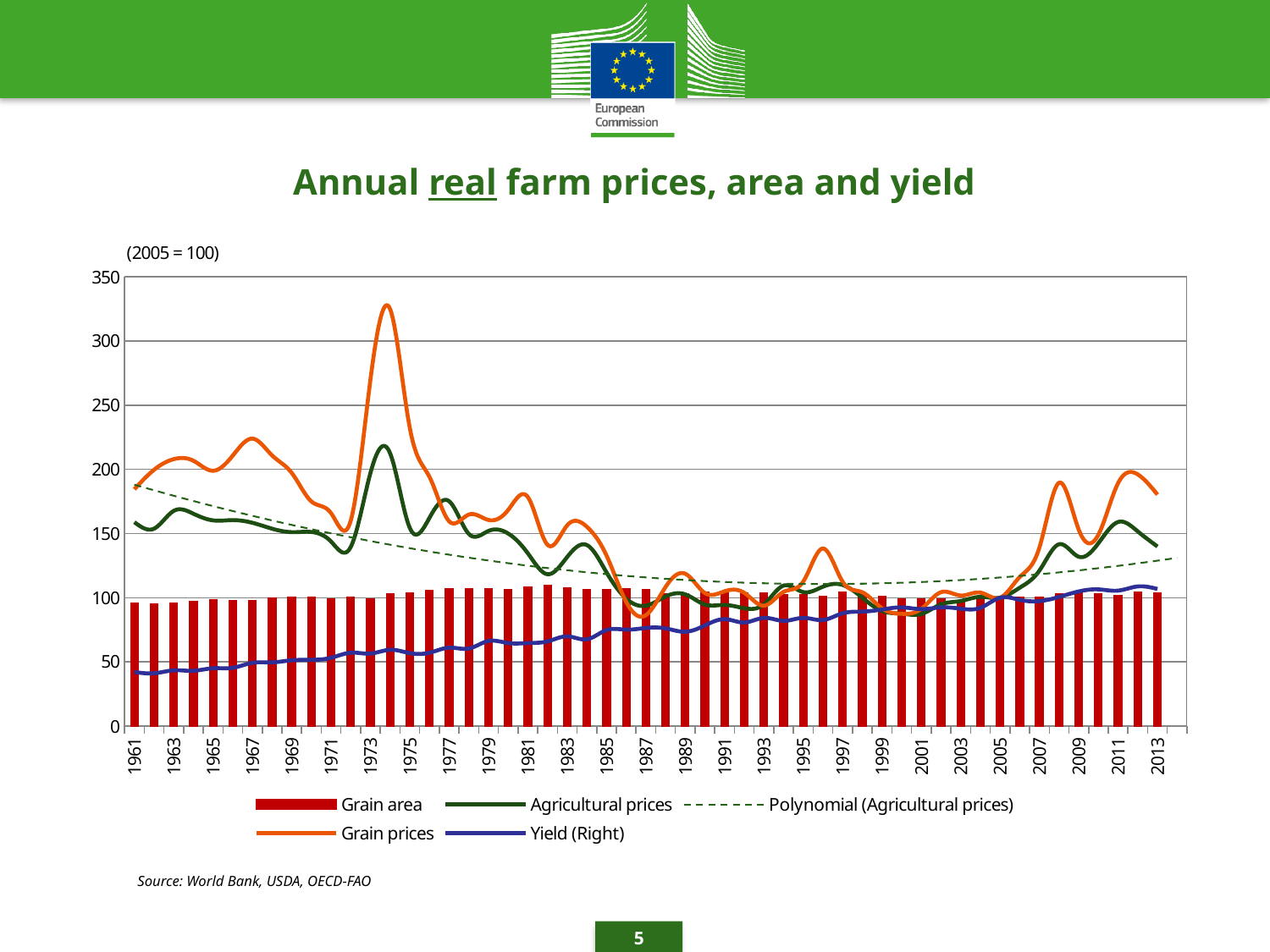
Which series is plotted as bars? Grain area What kind of chart is shown on the slide? A combined bar and line chart What base year is used for the index (shown above the chart)? 2005 = 100 Does the Agricultural prices series generally rise or fall from 1961 to 1987? fall How many series does the legend list? 5 In 1974, which is larger: Grain prices or Agricultural prices? Grain prices Is the value for Grain prices in 1974 greater or less than 300? greater Is the value for Yield (Right) in 1961 greater or less than 50? less Is the value for Grain prices in 2011 greater or less than 150? greater In which year do Grain prices reach their highest value? 1974 Does the Yield (Right) series generally rise or fall from 1961 to 2013? rise